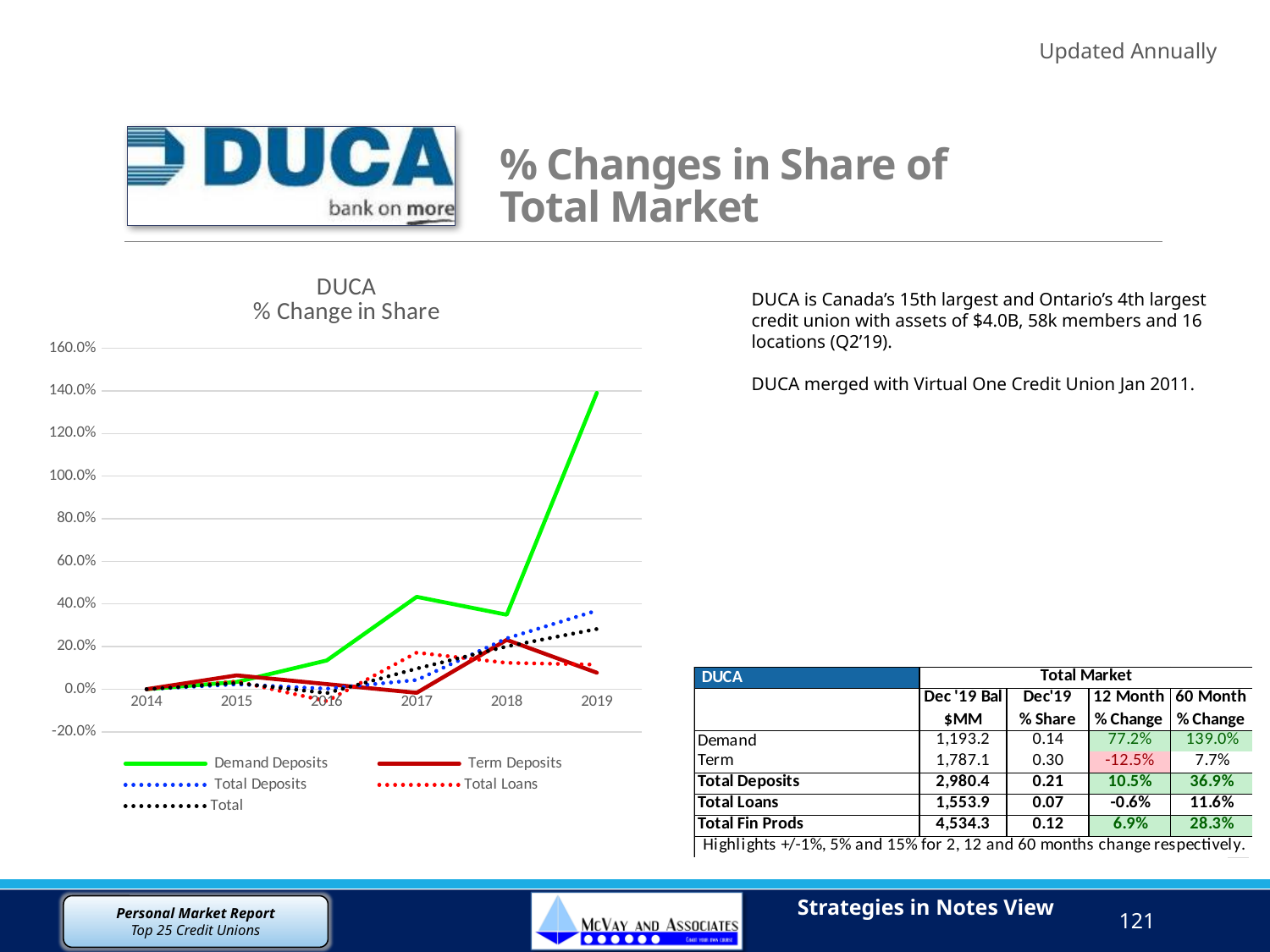
Is the value for Term Deposits in 2019 greater or less than 20%? less In 2019, which is larger: Total Deposits or Term Deposits? Total Deposits In 2019, which is larger: Demand Deposits or Total? Demand Deposits How many years are plotted along the x axis of the chart? 6 What kind of chart is shown on the slide? line chart How many series does the chart legend list? 5 Does the Term Deposits line rise or fall from 2018 to 2019? fall What colour is the Demand Deposits line in the chart? green Which series has the highest value in 2019? Demand Deposits Is the value for Demand Deposits in 2019 greater or less than 120%? greater Does the Demand Deposits line rise or fall from 2018 to 2019? rise Is the value for Demand Deposits in 2017 greater or less than 20%? greater